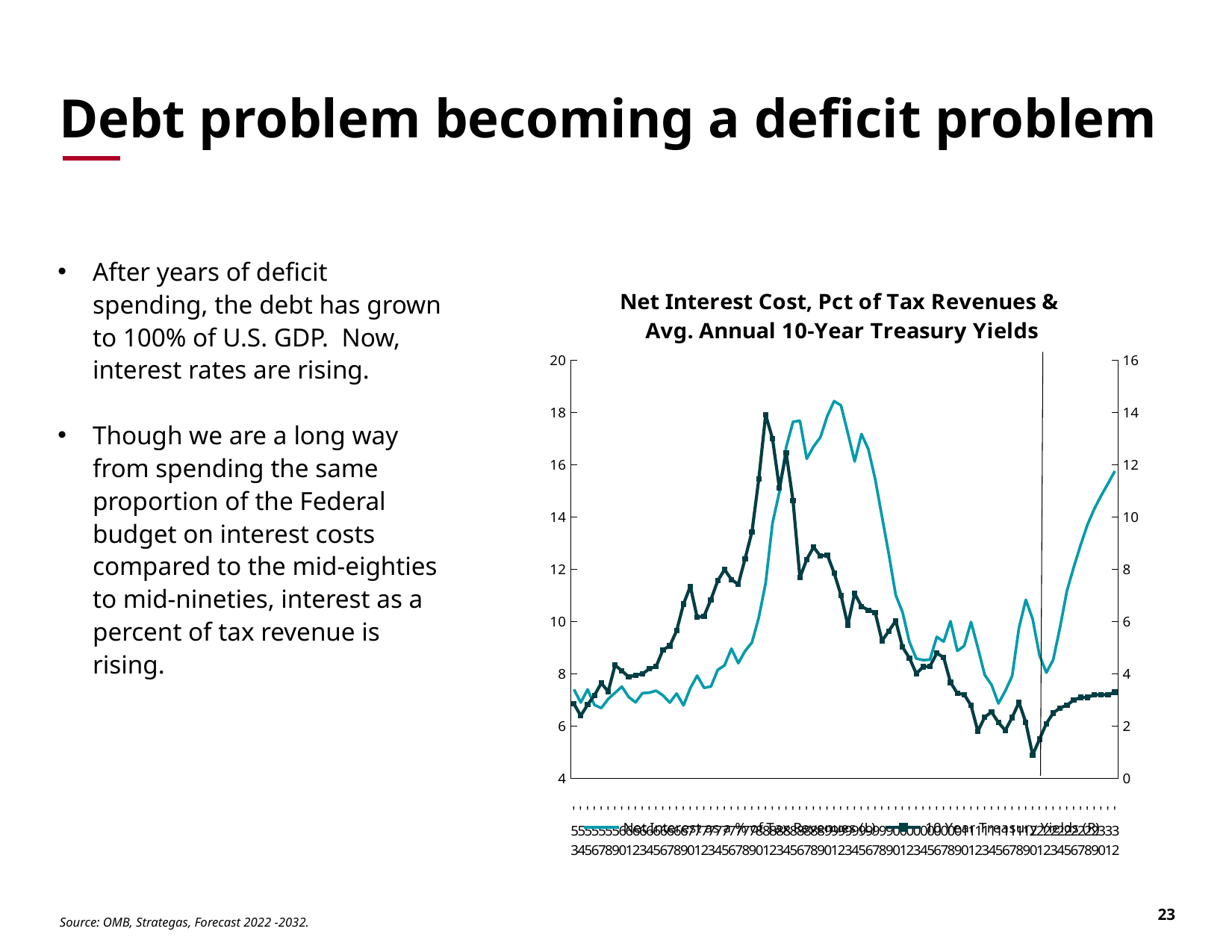
Does the 10-Year Treasury Yields line rise or fall from its peak in the early 1980s to the 2020 low? fall In the forecast section at the right end of the chart, does the Net Interest as a % of Tax Revenues line rise or fall? rise Is the lowest value reached by the 10-Year Treasury Yields line greater or less than 2 on the right axis? less How many series does the chart's legend list? 2 Which series is plotted on the right-hand axis according to the legend? 10 Year Treasury Yields (R) Is the highest value reached by the 10-Year Treasury Yields line greater or less than 12 on the right axis? greater Is the highest value reached by the Net Interest as a % of Tax Revenues line greater or less than 16 on the left axis? greater What kind of chart is shown on the slide? Line chart What is the title of the chart? Net Interest Cost, Pct of Tax Revenues & Avg. Annual 10-Year Treasury Yields